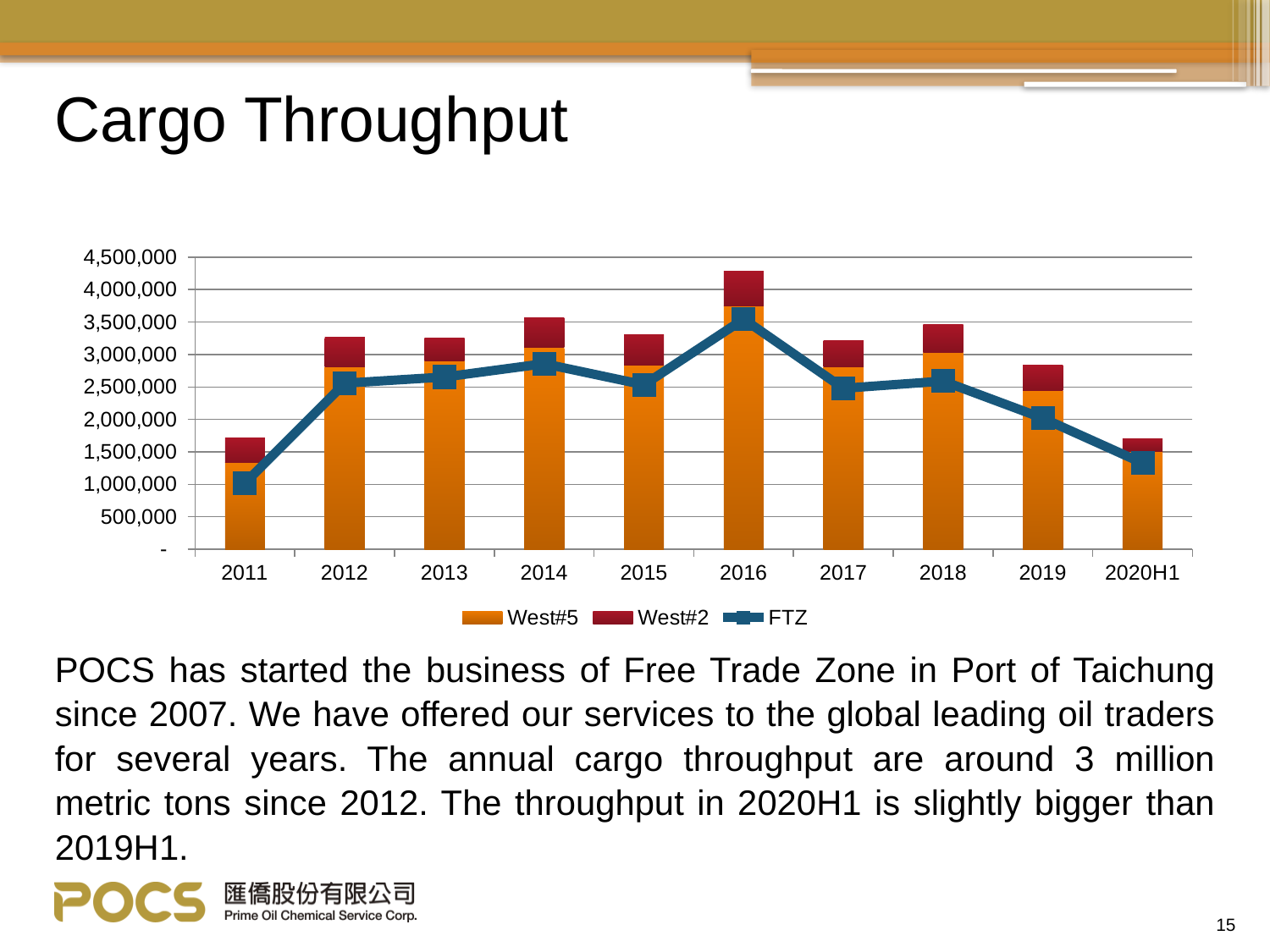
Which year has the highest total stacked bar? 2016 How many categories are shown on the x axis of the chart? 10 Is the total stacked bar for 2016 greater or less than 4,000,000? greater Is the total stacked bar for 2011 greater or less than 2,000,000? less Does the FTZ line rise or fall from 2016 to 2020H1? fall In which year is the FTZ line at its highest point? 2016 Is the total stacked bar for 2012 greater or less than 3,000,000? greater In which year is the FTZ line at its lowest point? 2011 How many series does the chart's legend list? 3 What kind of chart is shown on the slide? Stacked bar chart with a line Which has the larger total stacked bar, 2016 or 2017? 2016